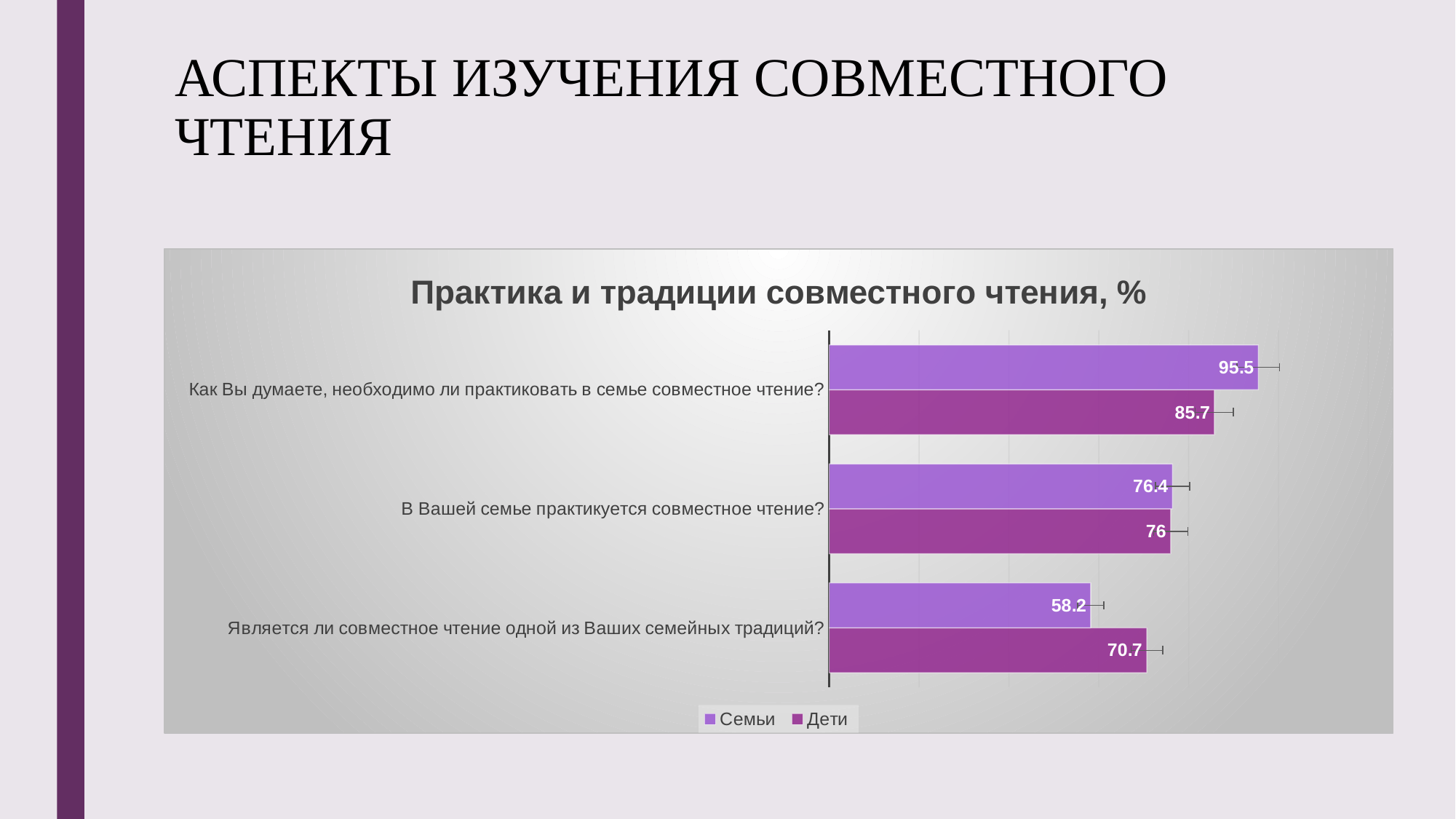
How many series does the legend list? 2 What type of chart is shown on the slide? Bar chart Which category has the lowest value for the Дети series? Является ли совместное чтение одной из Ваших семейных традиций? Which category has the highest value for the Семьи series? Как Вы думаете, необходимо ли практиковать в семье совместное чтение? What is the value for Семьи on the question "Как Вы думаете, необходимо ли практиковать в семье совместное чтение?"? 95.5 For "Является ли совместное чтение одной из Ваших семейных традиций?", which series has the larger value, Семьи or Дети? Дети What are the two series named in the legend? Семьи and Дети How many question categories are shown on the chart? 3 What is the title of the chart? Практика и традиции совместного чтения, % What is the value for Дети on the question "В Вашей семье практикуется совместное чтение?"? 76 What is the value for Дети on the question "Является ли совместное чтение одной из Ваших семейных традиций?"? 70.7 What is the difference between the Семьи and Дети values for "Как Вы думаете, необходимо ли практиковать в семье совместное чтение?"? 9.8